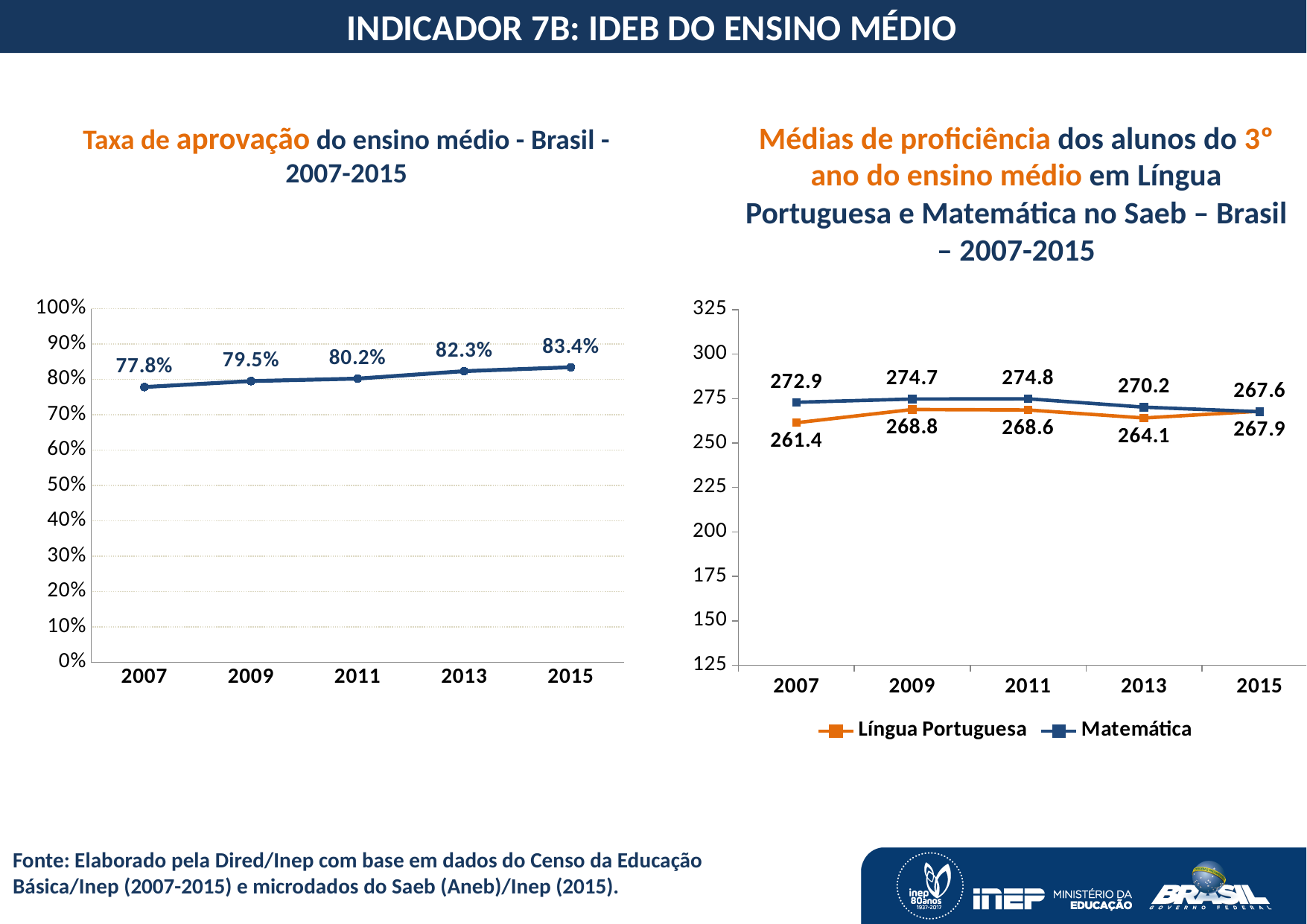
In the left chart (Taxa de aprovação do ensino médio), what is the approval rate for 2007? 77.8% In the left chart (Taxa de aprovação do ensino médio), what type of chart is shown? line chart In the right chart (Médias de proficiência), which series is drawn in orange? Língua Portuguesa In the right chart (Médias de proficiência), what is the Matemática value for 2011? 274.8 In the right chart (Médias de proficiência), what is the Língua Portuguesa value for 2013? 264.1 In the right chart (Médias de proficiência), what is the difference between the Matemática and Língua Portuguesa values in 2007? 11.5 In the left chart (Taxa de aprovação do ensino médio), what is the approval rate for 2015? 83.4% In the left chart (Taxa de aprovação do ensino médio), do the values rise or fall from 2007 to 2015? rise In the left chart (Taxa de aprovação do ensino médio), how many years are plotted? 5 In the right chart (Médias de proficiência), which year has the highest Matemática value? 2011 In the left chart (Taxa de aprovação do ensino médio), which year has the lowest approval rate? 2007 In the right chart (Médias de proficiência), how many series does the legend list? 2